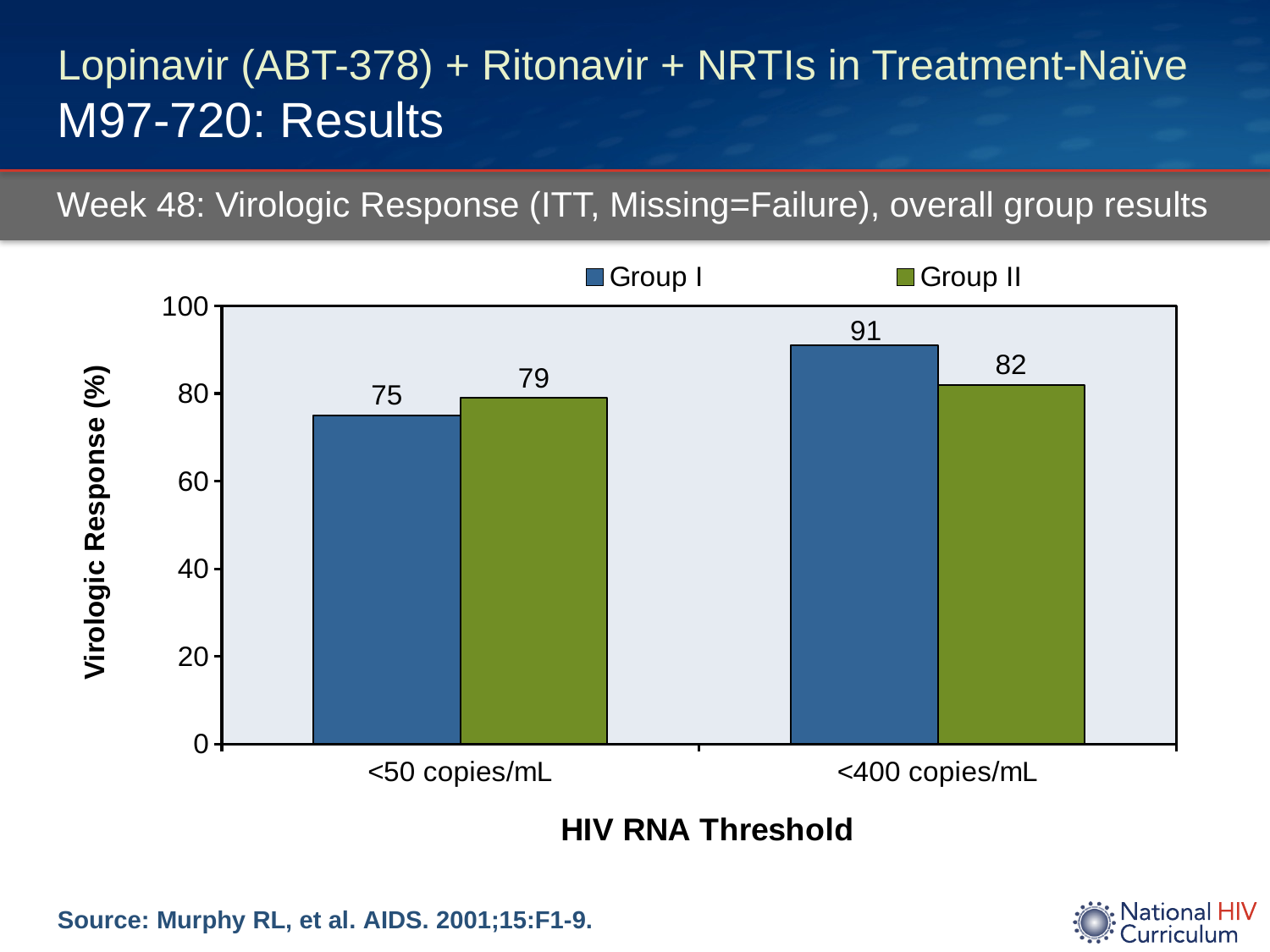
What is the virologic response for Group II at the <400 copies/mL threshold? 82 Which bar has the lowest value on the chart? Group I at <50 copies/mL How many HIV RNA threshold categories are shown on the x axis? 2 What is the virologic response for Group I at the <400 copies/mL threshold? 91 Which bar has the highest value on the chart? Group I at <400 copies/mL What kind of chart is shown on the slide? Bar chart At the <50 copies/mL threshold, which group has the larger virologic response? Group II What is the virologic response for Group I at the <50 copies/mL threshold? 75 What is the label of the y axis? Virologic Response (%) How many series does the legend list? 2 What is the difference between Group II at <400 copies/mL and Group II at <50 copies/mL? 3 What is the difference between Group I and Group II at the <400 copies/mL threshold? 9